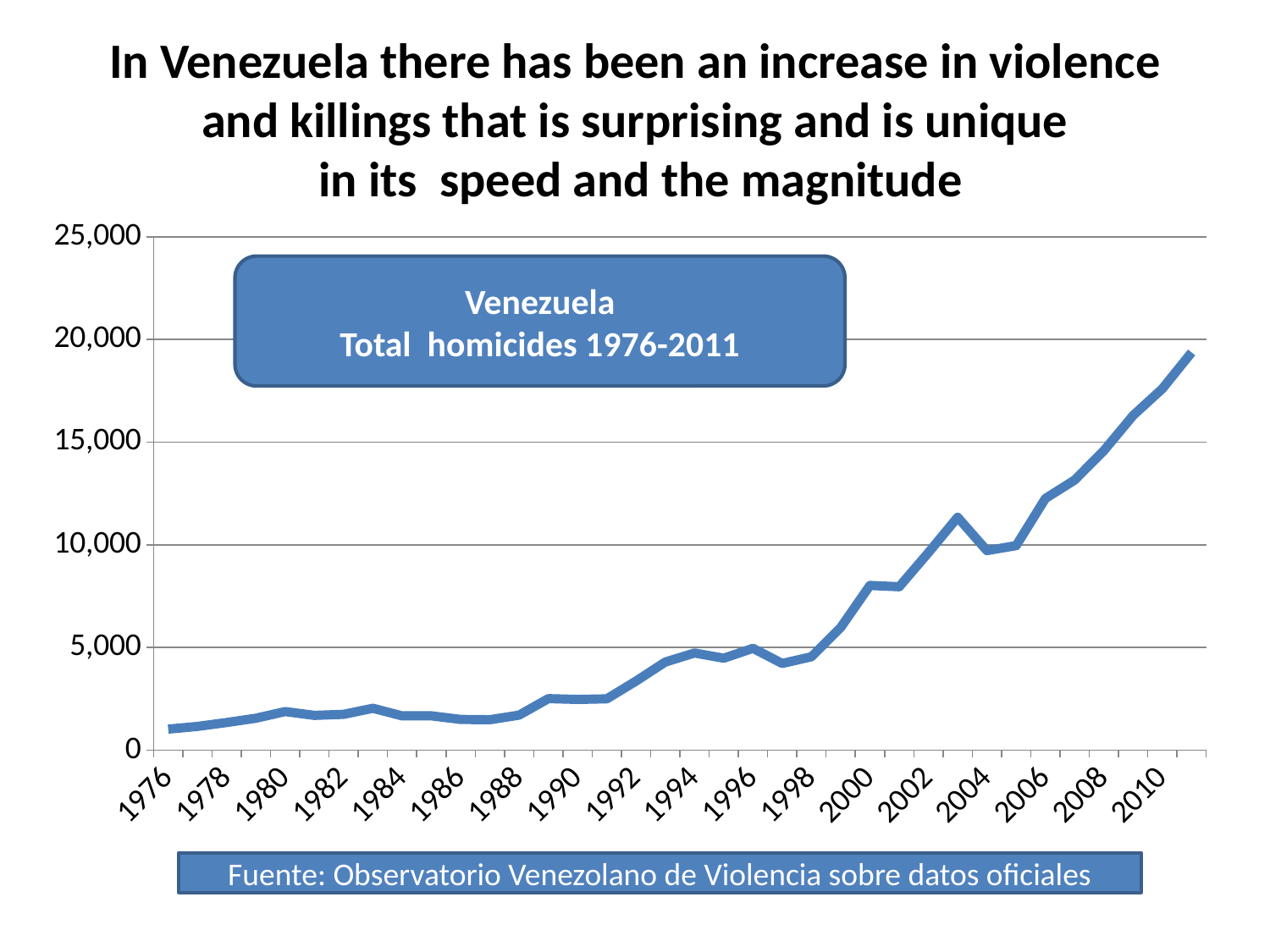
What is the title shown in the box on the chart? Venezuela Total homicides 1976-2011 Is the value for 1976 greater or less than 5,000? less Which year has the larger value, 1990 or 2000? 2000 Is the value for 2010 greater or less than 15,000? greater What kind of chart is shown on the slide? line chart Is the value for 2006 greater or less than 10,000? greater What source is cited below the chart? Fuente: Observatorio Venezolano de Violencia sobre datos oficiales Is the highest value of the series at the beginning or at the end of the period? at the end Overall, do the total homicides rise or fall from 1976 to the end of the series? rise Which year has the larger value, 1976 or 2010? 2010